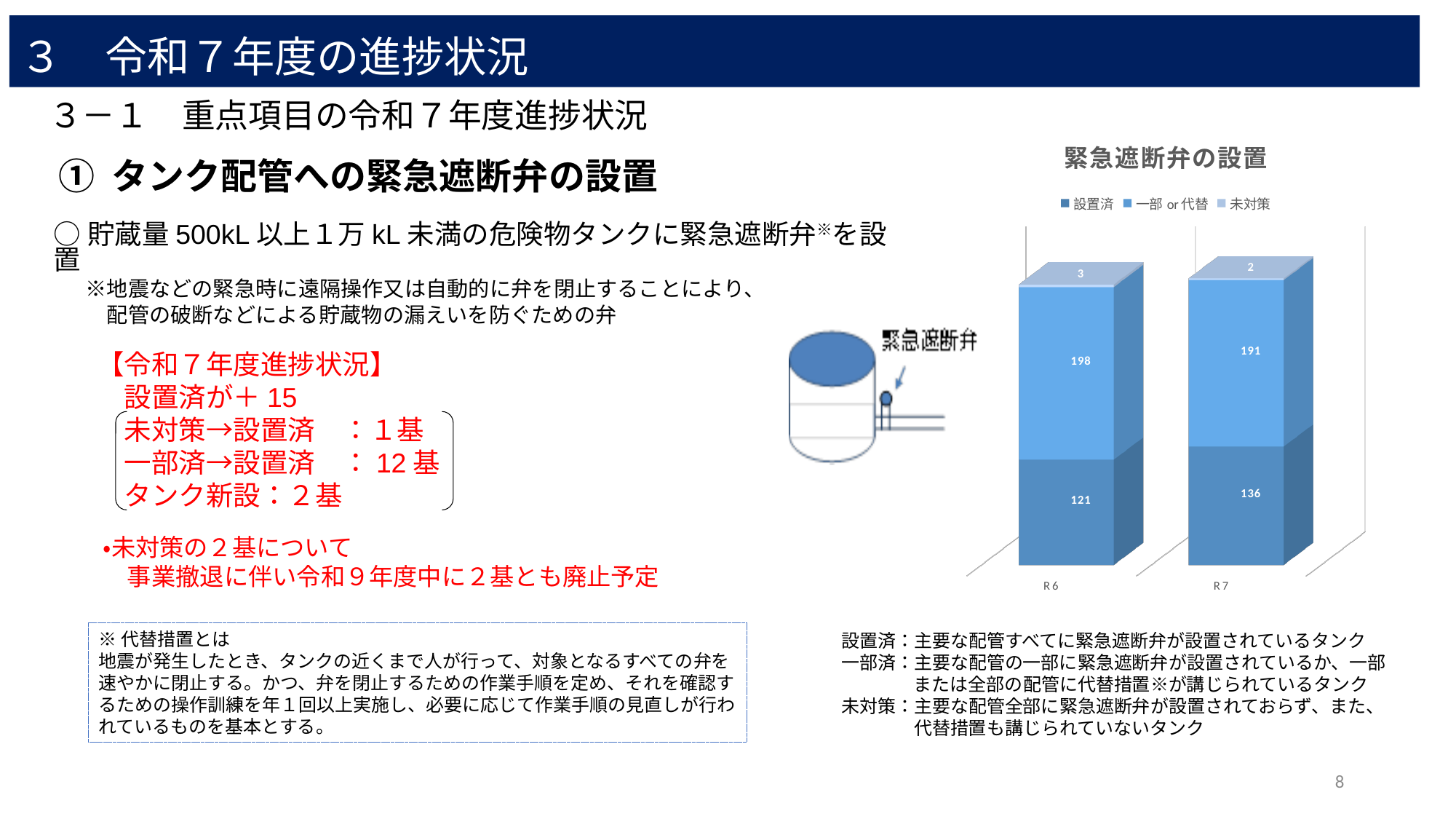
What is the title of the chart on the slide? 緊急遮断弁の設置 What is the total of the stacked bar for R7? 329 What is the value of 設置済 for R7? 136 What is the difference between the 設置済 values for R7 and R6? 15 How many series does the chart legend list? 3 What is the total of the stacked bar for R6? 322 How many categories are shown on the x axis of the chart? 2 Which is larger, the 一部 or 代替 value for R6 or for R7? R6 What is the value of 一部 or 代替 for R6? 198 What is the value of 未対策 for R7? 2 What type of chart is shown on the slide? stacked bar chart What is the value of 設置済 for R6? 121